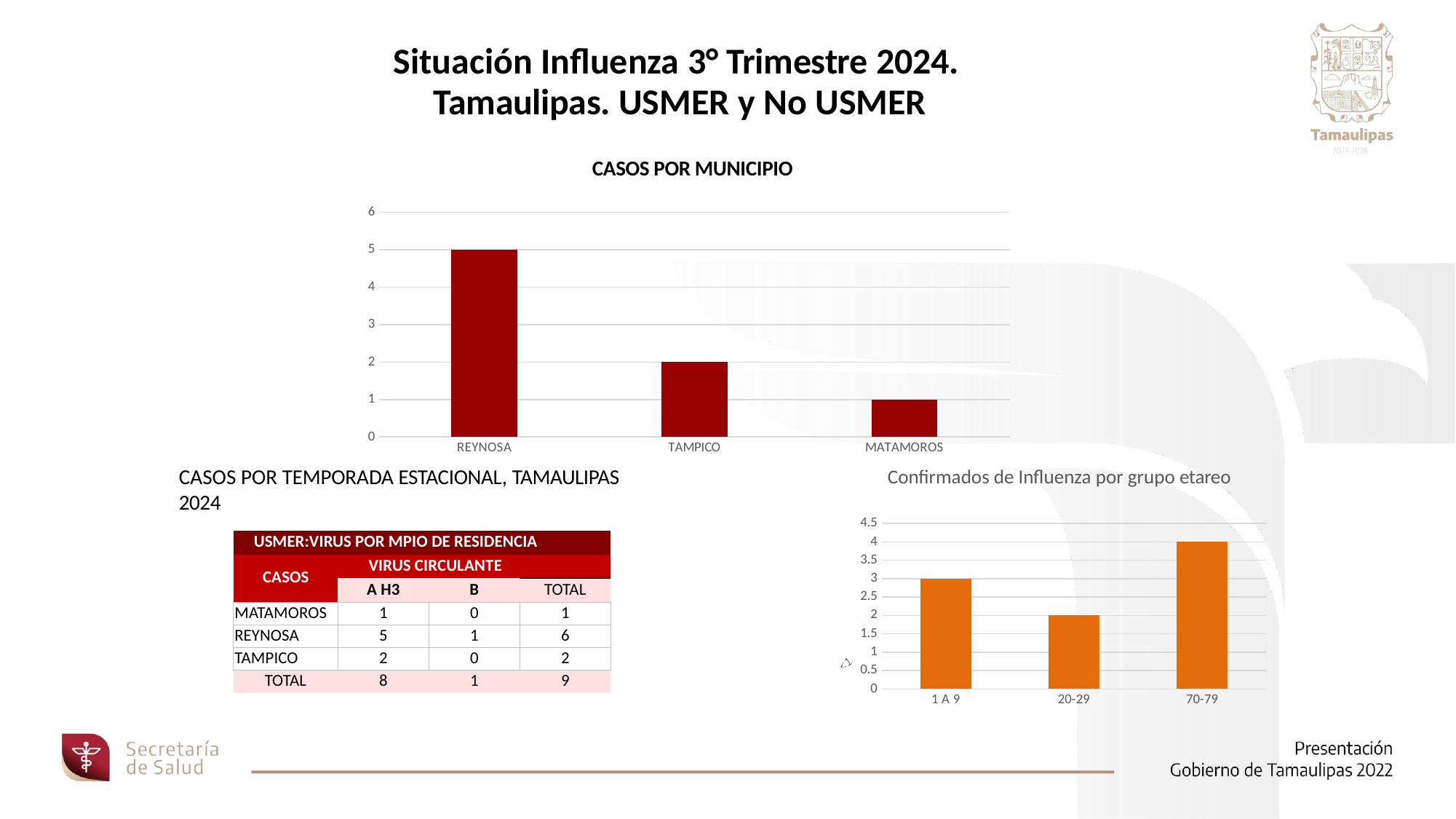
In the 'Confirmados de Influenza por grupo etareo' chart, which age group has the highest value? 70-79 In the 'CASOS POR MUNICIPIO' chart, how many municipalities are shown on the x axis? 3 In the 'Confirmados de Influenza por grupo etareo' chart, which is larger, the value for 1 A 9 or the value for 20-29? 1 A 9 In the 'CASOS POR MUNICIPIO' chart, what is the difference between the values for REYNOSA and TAMPICO? 3 In the 'CASOS POR MUNICIPIO' chart, which municipality has the highest value? REYNOSA In the 'Confirmados de Influenza por grupo etareo' chart, what colour are the bars? Orange In the 'Confirmados de Influenza por grupo etareo' chart, what is the value for the 1 A 9 group? 3 In the 'CASOS POR MUNICIPIO' chart, what is the value for TAMPICO? 2 In the 'CASOS POR MUNICIPIO' chart, what is the value for REYNOSA? 5 In the 'CASOS POR MUNICIPIO' chart, which municipality has the lowest value? MATAMOROS In the 'Confirmados de Influenza por grupo etareo' chart, what is the value for the 70-79 group? 4 What kind of chart is 'CASOS POR MUNICIPIO'? Bar chart